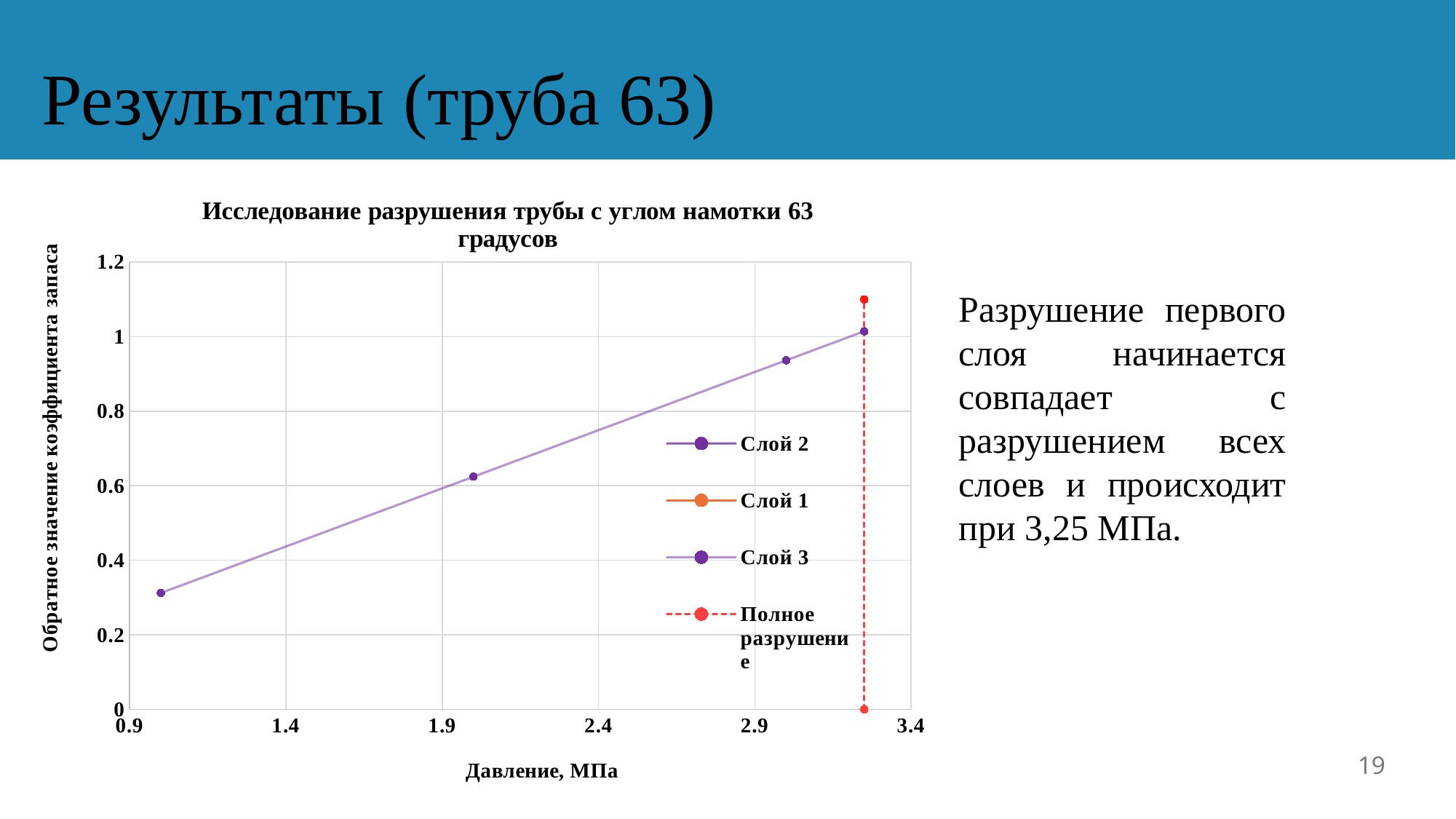
Is the value of the leftmost point on the layer line greater or less than 0.4? less Is the value of the rightmost point on the layer line greater or less than 0.8? greater How many series does the chart legend list? 4 What kind of chart is shown on the slide? Line chart Is the value of the point near 3.0 MPa on the layer line greater or less than 0.8? greater Do the plotted values of the layer line rise or fall as pressure increases along the x axis? Rise What is the title of the chart? Исследование разрушения трубы с углом намотки 63 градусов How many data points are plotted on the solid layer line? 4 Which point on the layer line has the highest value: the leftmost or the rightmost? The rightmost What is the label of the x axis of the chart? Давление, МПа